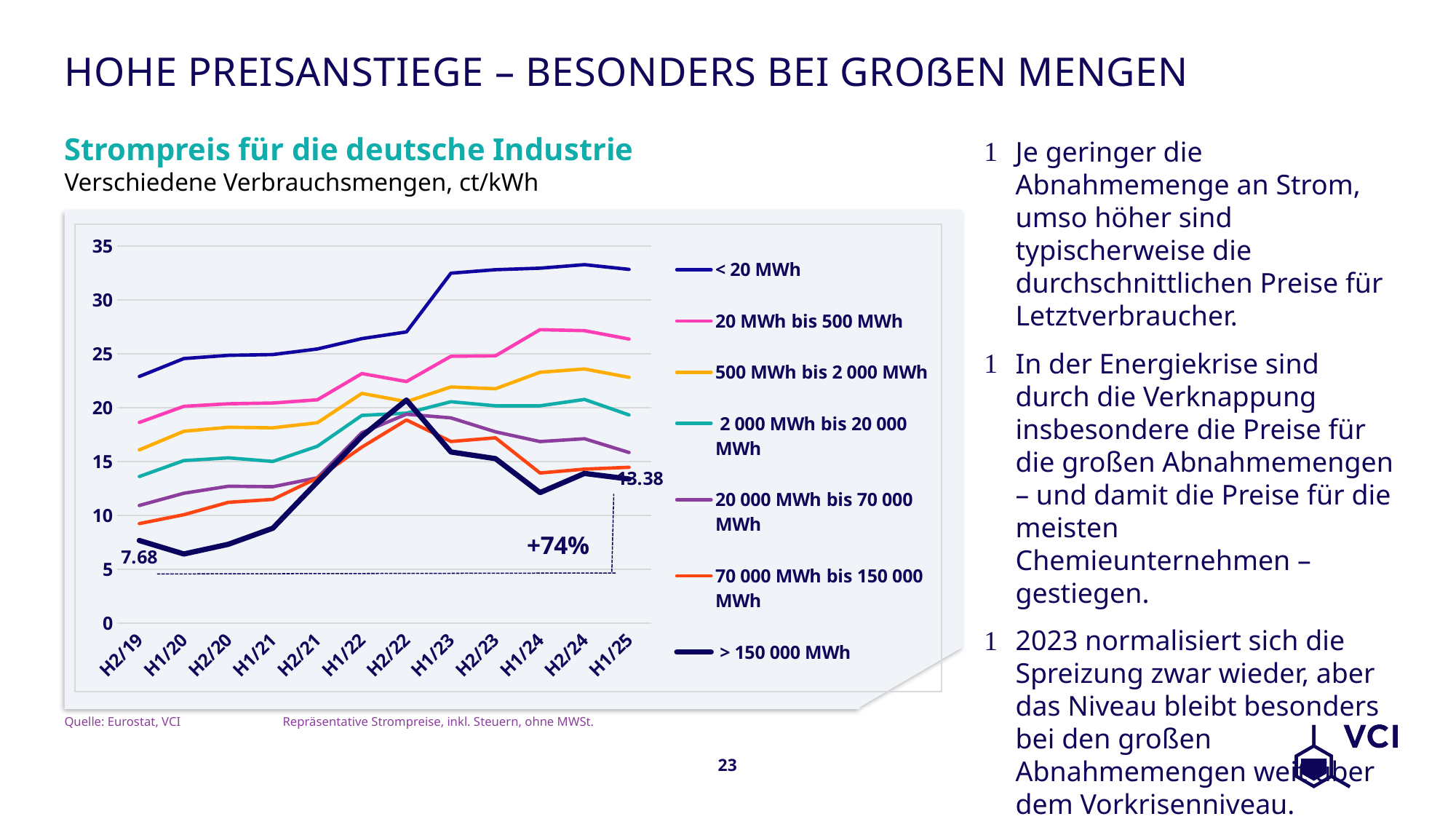
Which series has the highest value at H1/25? < 20 MWh Is the value for the 20 MWh bis 500 MWh series at H2/19 greater or less than 15? greater What kind of chart is shown on the slide? line chart What is the value for the > 150 000 MWh series at H2/19? 7.68 Does the < 20 MWh series rise or fall from H2/19 to H1/23? rise How many time periods are shown on the x axis? 12 By how much did the > 150 000 MWh series increase from H2/19 to H1/25? 5.70 How many series does the legend list? 7 What percentage change is annotated on the chart for the > 150 000 MWh series? +74% Which series has the lowest value at H2/19? > 150 000 MWh What is the value for the > 150 000 MWh series at H1/25? 13.38 Is the value for the < 20 MWh series at H1/25 greater or less than 30? greater